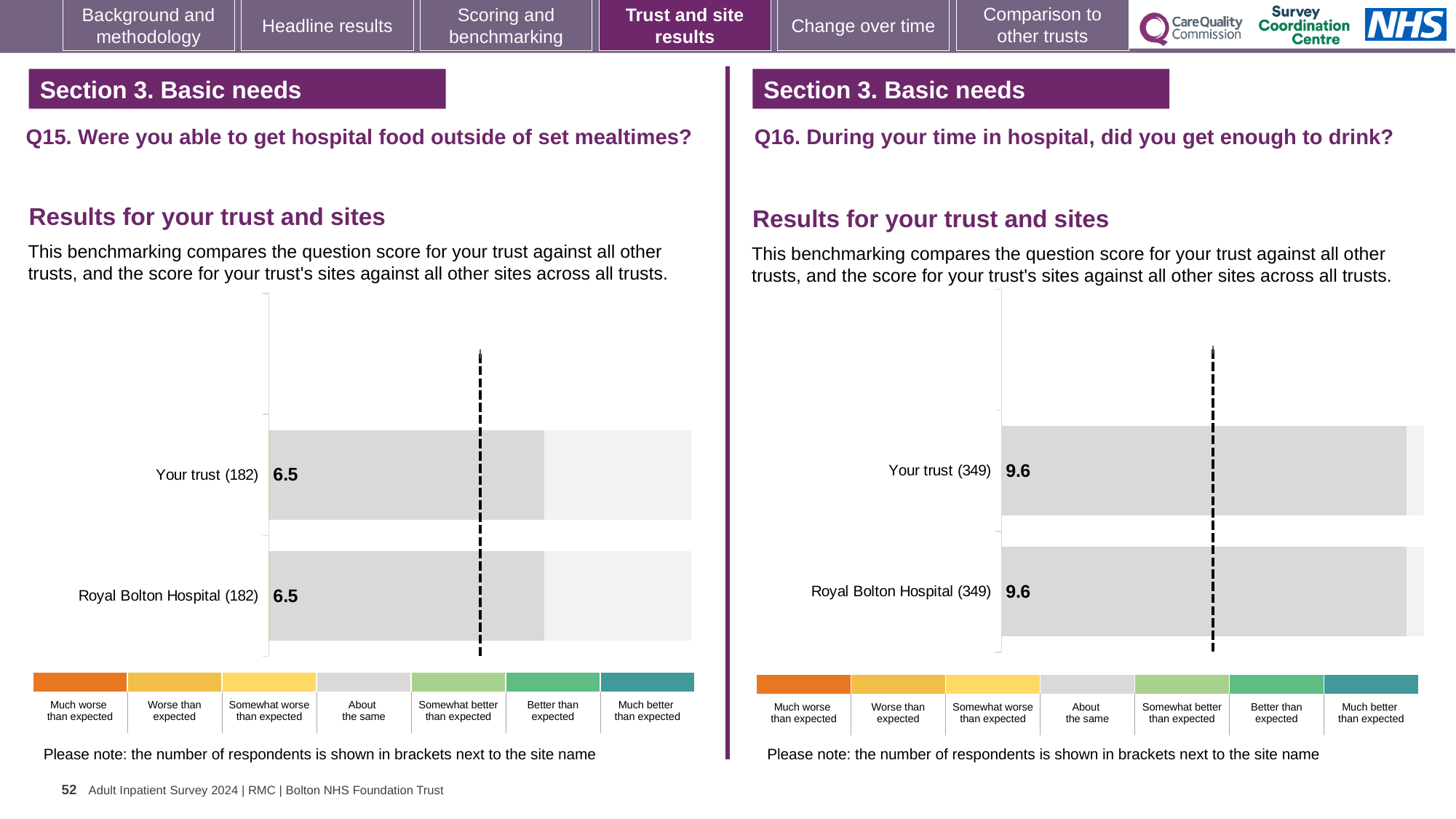
Is the score for Your trust on the Q16 chart (right) larger or smaller than the score for Your trust on the Q15 chart (left)? Larger How many bars are plotted on the Q16 chart (right)? 2 On the Q15 chart (left), what is the score for Your trust? 6.5 On the Q16 chart (right), what is the difference between the score for Your trust and the score for Royal Bolton Hospital? 0 On the Q16 chart (right), what is the score for Royal Bolton Hospital? 9.6 On the Q16 chart (right), how many respondents are shown in brackets for Your trust? 349 On the Q15 chart (left), how many respondents are shown in brackets for Royal Bolton Hospital? 182 On the Q15 chart (left), what is the score for Royal Bolton Hospital? 6.5 How many bars are plotted on the Q15 chart (left)? 2 On the Q16 chart (right), what is the score for Your trust? 9.6 What kind of chart is the Q15 chart (left)? Bar chart On the Q15 chart (left), what is the difference between the score for Your trust and the score for Royal Bolton Hospital? 0